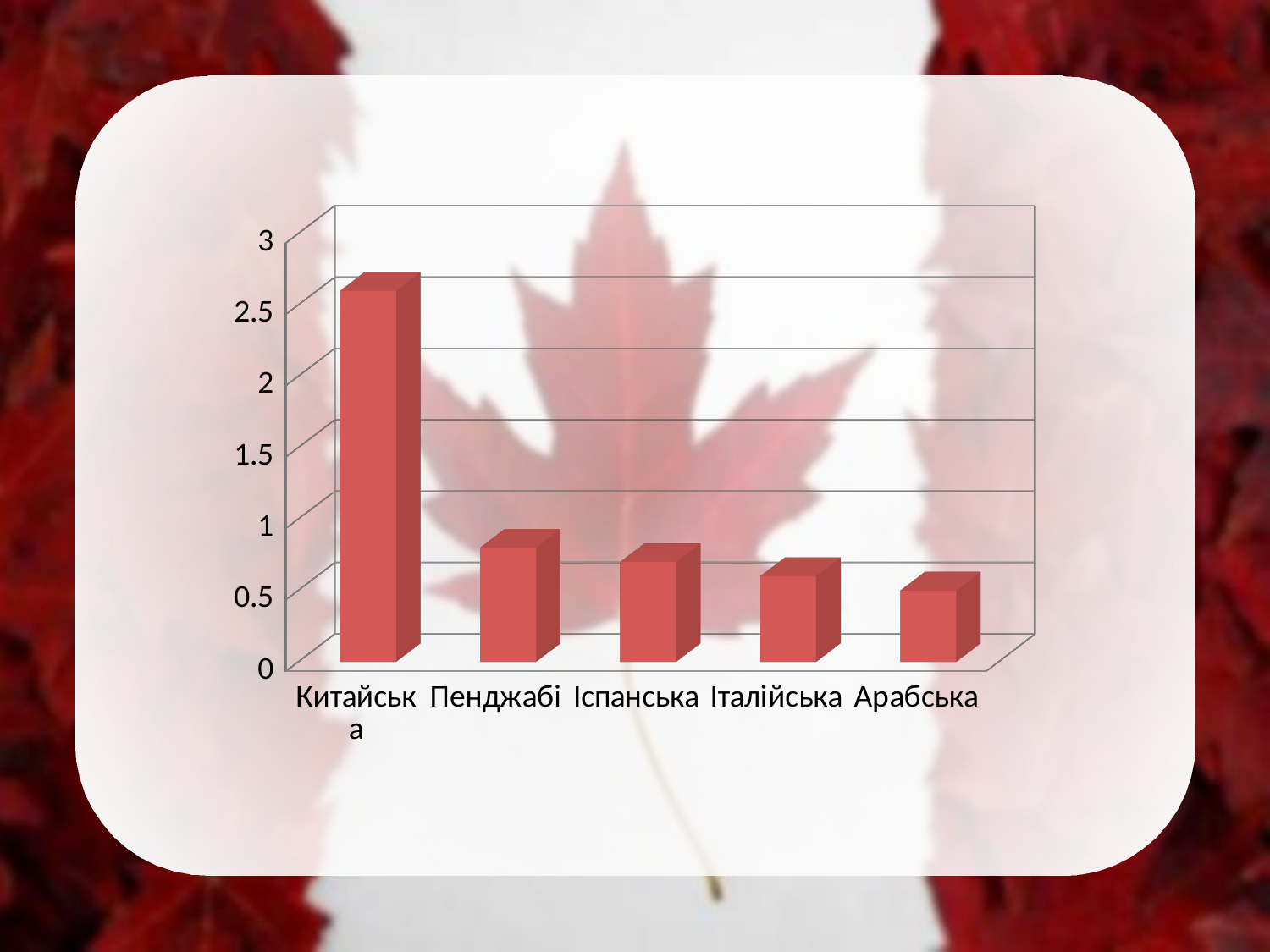
How many categories are shown on the x axis of the chart? 5 Which is larger, the value for Пенджабі or the value for Арабська? Пенджабі What colour are the bars in the chart? red Which category has the highest bar in the chart? Китайська Which category has the lowest bar in the chart? Арабська Which is larger, the value for Китайська or the value for Пенджабі? Китайська What kind of chart is shown on the slide? bar chart Do the bar values rise or fall from left to right along the x axis? fall Is the value for Пенджабі greater or less than 1? less Is the value for Арабська greater or less than 1? less Is the value for Китайська greater or less than 2? greater